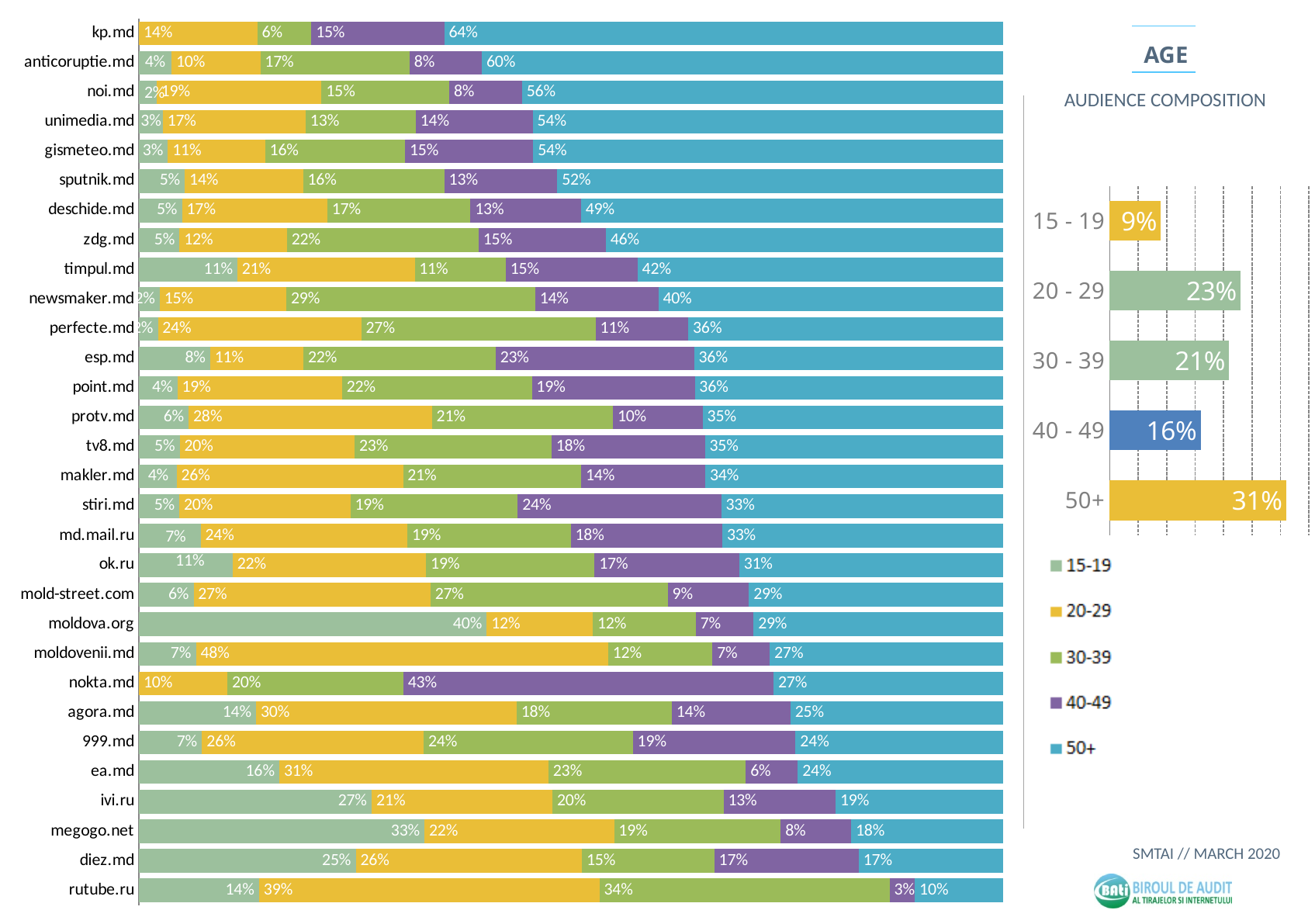
In the stacked bar chart of websites on the left, what is the 50+ share for kp.md? 64% In the stacked bar chart of websites on the left, which website has the largest 50+ share? kp.md In the AGE audience composition chart on the right, what is the value for the 50+ age group? 31% How many age groups are shown in the AGE audience composition chart on the right? 5 In the stacked bar chart of websites on the left, what is the 15-19 share for moldova.org? 40% How many age-group series does the legend of the stacked bar chart on the left list? 5 In the AGE audience composition chart on the right, which age group has the lowest value? 15 - 19 In the stacked bar chart of websites on the left, what is the 40-49 share for nokta.md? 43% What type of chart is the large chart of websites on the left of the slide? Stacked bar chart In the AGE audience composition chart on the right, what is the difference between the 20 - 29 and 30 - 39 values? 2 percentage points In the AGE audience composition chart on the right, which age group has the highest value? 50+ In the stacked bar chart of websites on the left, which website has the smallest 50+ share? rutube.ru